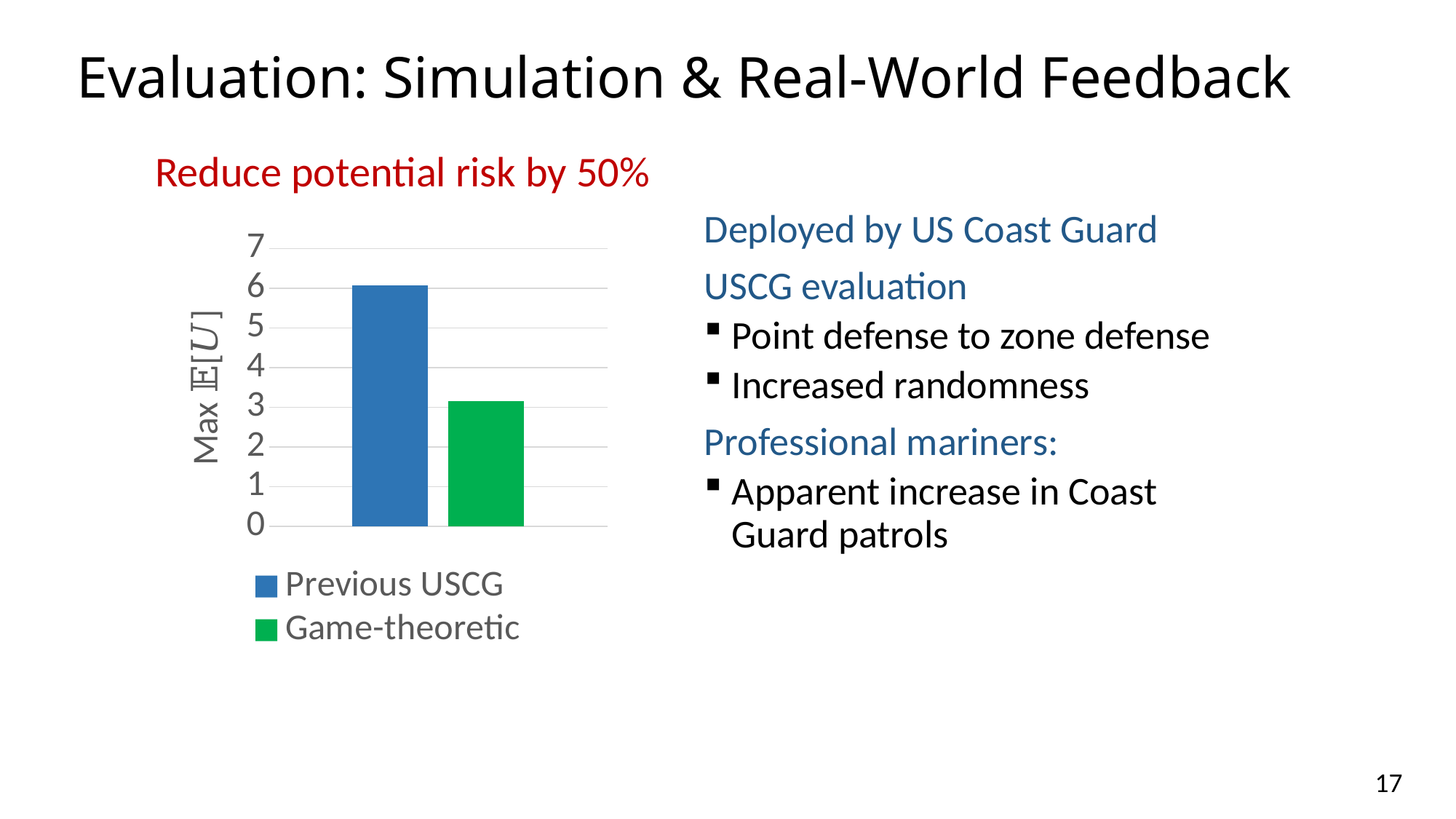
What kind of chart is shown on the slide? bar chart Which is larger, the value for Previous USCG or the value for Game-theoretic? Previous USCG What is the label on the vertical axis of the chart? Max E[U] How many bars are plotted in the chart? 2 Is the value for Game-theoretic greater or less than 2? greater Which series has the lowest bar in the chart? Game-theoretic Is the value for Previous USCG greater or less than 5? greater How many series does the chart legend list? 2 Which series has the highest bar in the chart? Previous USCG Is the value for Game-theoretic greater or less than 4? less What colour is the bar for Game-theoretic in the chart? green